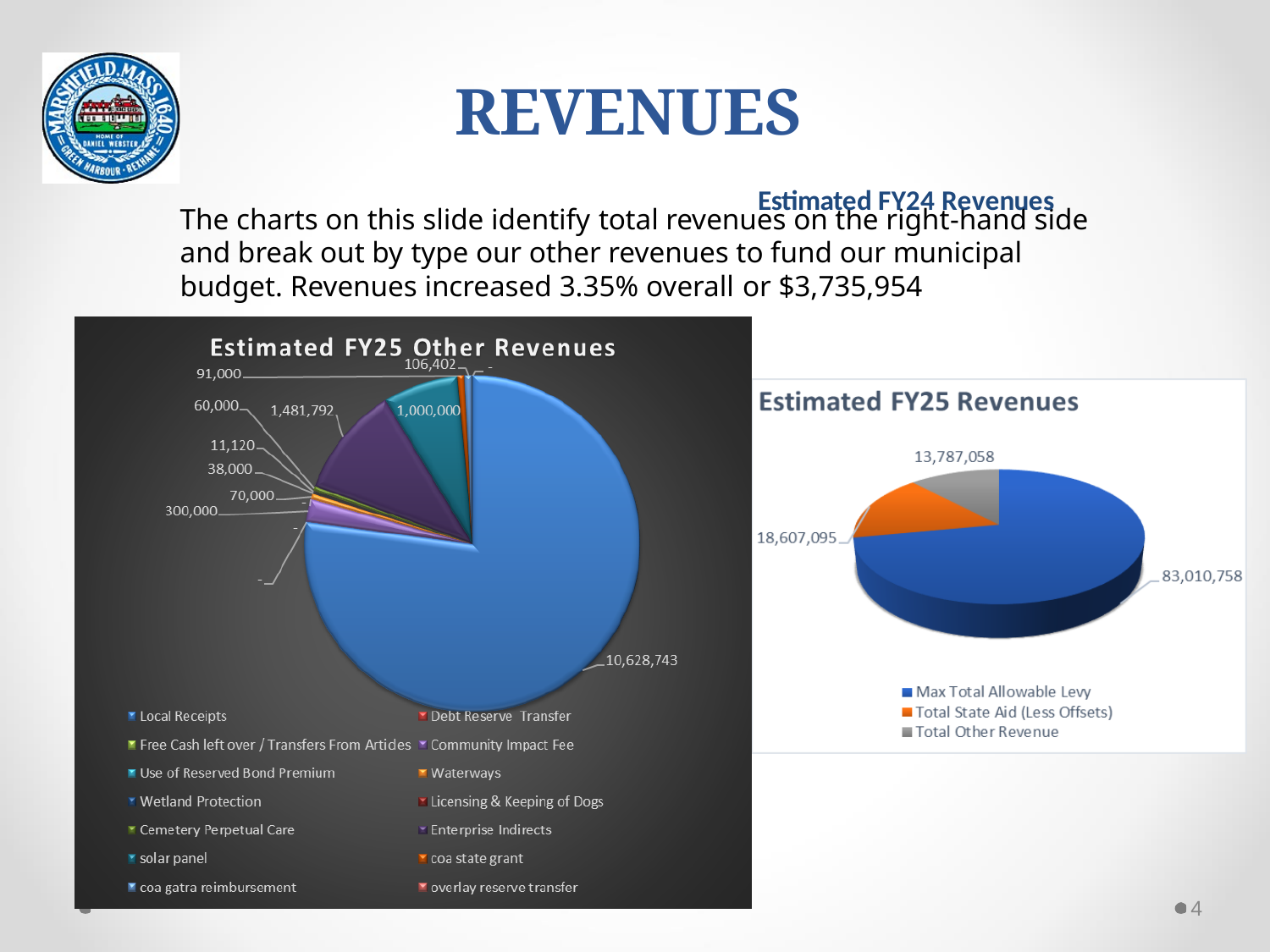
In the Estimated FY25 Revenues chart, which category has the largest slice? Max Total Allowable Levy In the Estimated FY25 Revenues chart, which category has the smallest slice? Total Other Revenue In the Estimated FY25 Revenues chart, what is the difference between Max Total Allowable Levy and Total State Aid (Less Offsets)? 64,403,663 In the Estimated FY25 Other Revenues chart, what is the difference between the slice labelled 1,481,792 and the slice labelled 1,000,000? 481,792 In the Estimated FY25 Revenues chart, what is the value for Total State Aid (Less Offsets)? 18,607,095 In the Estimated FY25 Revenues chart, what is the value for Total Other Revenue? 13,787,058 How many entries does the legend of the Estimated FY25 Other Revenues chart list? 14 How many entries does the legend of the Estimated FY25 Revenues chart list? 3 In the Estimated FY25 Other Revenues chart, what is the value of the largest slice (Local Receipts)? 10,628,743 In the Estimated FY25 Revenues chart, what is the value for Max Total Allowable Levy? 83,010,758 What kind of chart is the Estimated FY25 Other Revenues chart? Pie chart In the Estimated FY25 Revenues chart, what is the total of the three slices? 115,404,911